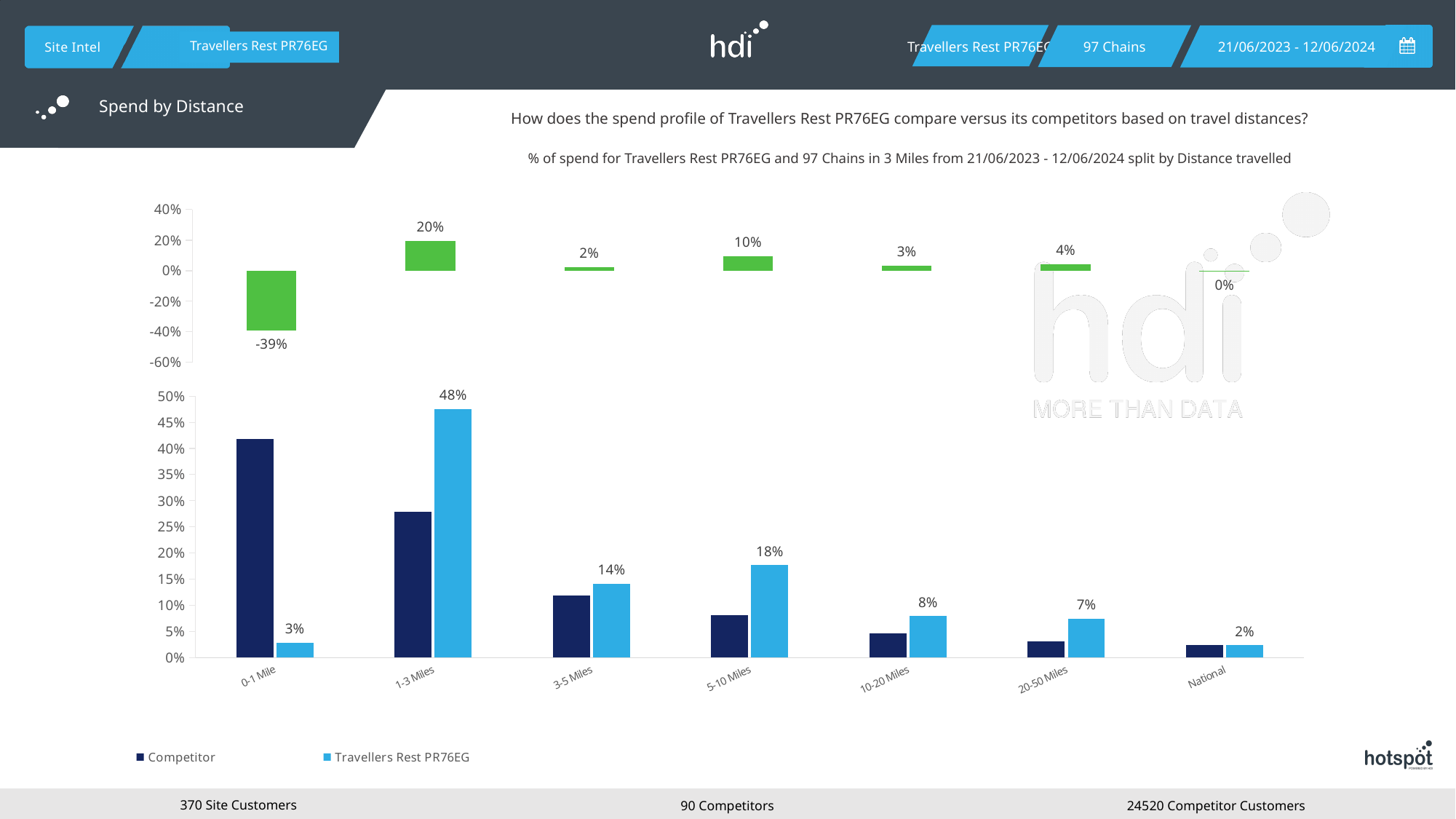
In the top chart, what is the value shown for 1-3 Miles? 20% In the bottom chart, which distance band has the highest value for Travellers Rest PR76EG? 1-3 Miles In the bottom chart, what is the value for Travellers Rest PR76EG at 1-3 Miles? 48% In the top chart, which distance band has the lowest value? 0-1 Mile How many series does the legend of the bottom chart list? 2 In the bottom chart, is the Competitor value for 0-1 Mile greater or less than 40%? greater What type of chart is the bottom chart? Bar chart In the bottom chart, what is the difference between the Travellers Rest PR76EG values at 1-3 Miles and 3-5 Miles? 34% How many distance categories are shown on the x axis of the bottom chart? 7 In the bottom chart at 0-1 Mile, which is larger: the Competitor bar or the Travellers Rest PR76EG bar? Competitor In the top chart, what is the value shown for 0-1 Mile? -39% In the bottom chart, what is the value for Travellers Rest PR76EG at 5-10 Miles? 18%